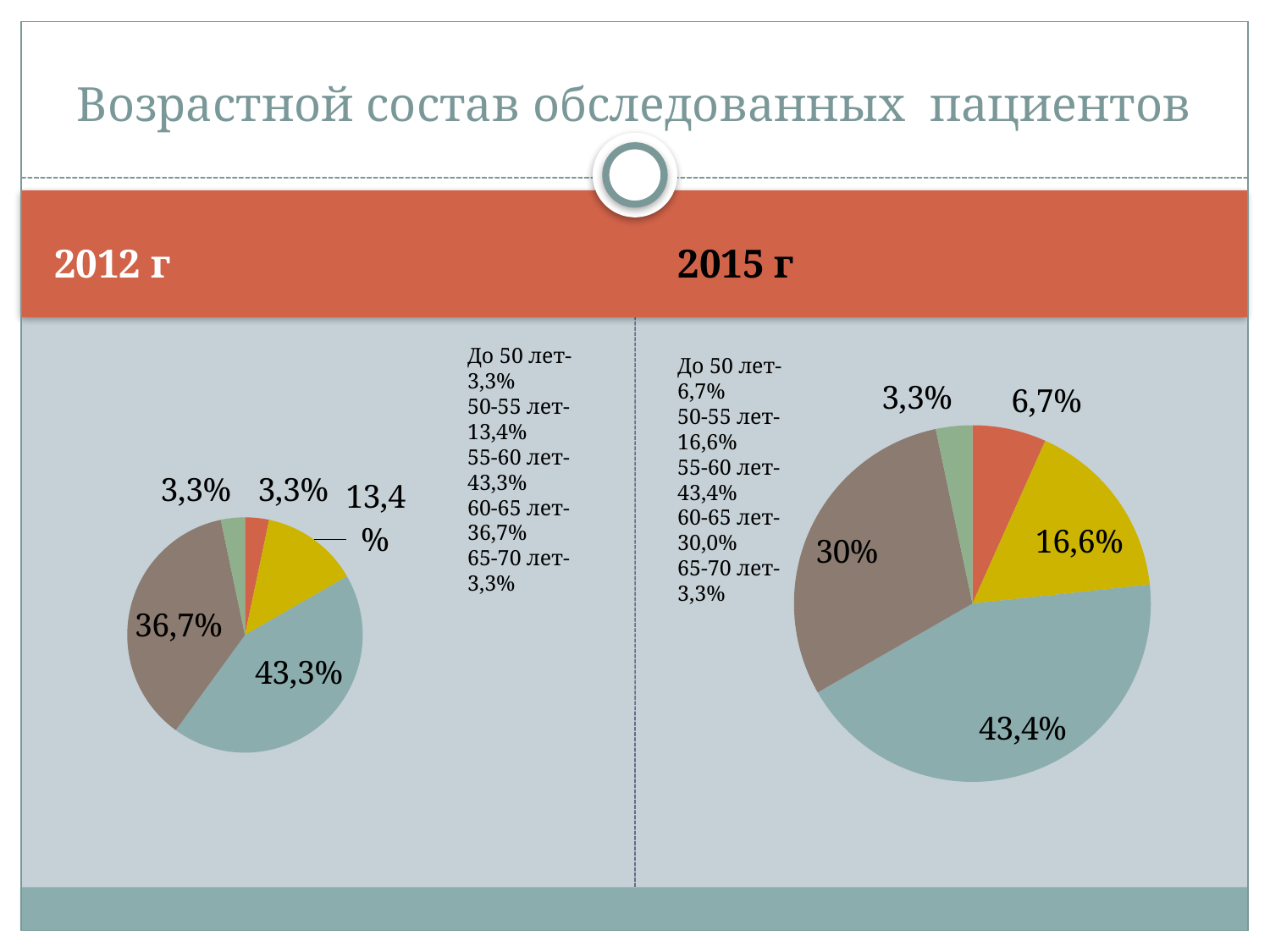
In the 2012 г chart, what is the difference between the shares for 55-60 лет and 50-55 лет? 29,9% In the 2015 г chart, which age group has the largest share? 55-60 лет Which is larger: the share for 60-65 лет in the 2012 г chart or in the 2015 г chart? 2012 г In the 2015 г chart, what share of patients were aged 50-55 лет? 16,6% In the 2012 г chart, what share of patients were aged 60-65 лет? 36,7% What kind of chart is used for the 2012 г data? pie chart In the 2015 г chart, what share of patients were aged До 50 лет? 6,7% In the 2015 г chart, which age group has the smallest share? 65-70 лет In the 2015 г chart, what is the difference between the shares for 55-60 лет and 60-65 лет? 13,4% In the 2012 г chart, what share of patients were aged 55-60 лет? 43,3% How many slices does the 2012 г pie chart have? 5 In the 2012 г chart, what share of patients were aged 50-55 лет? 13,4%